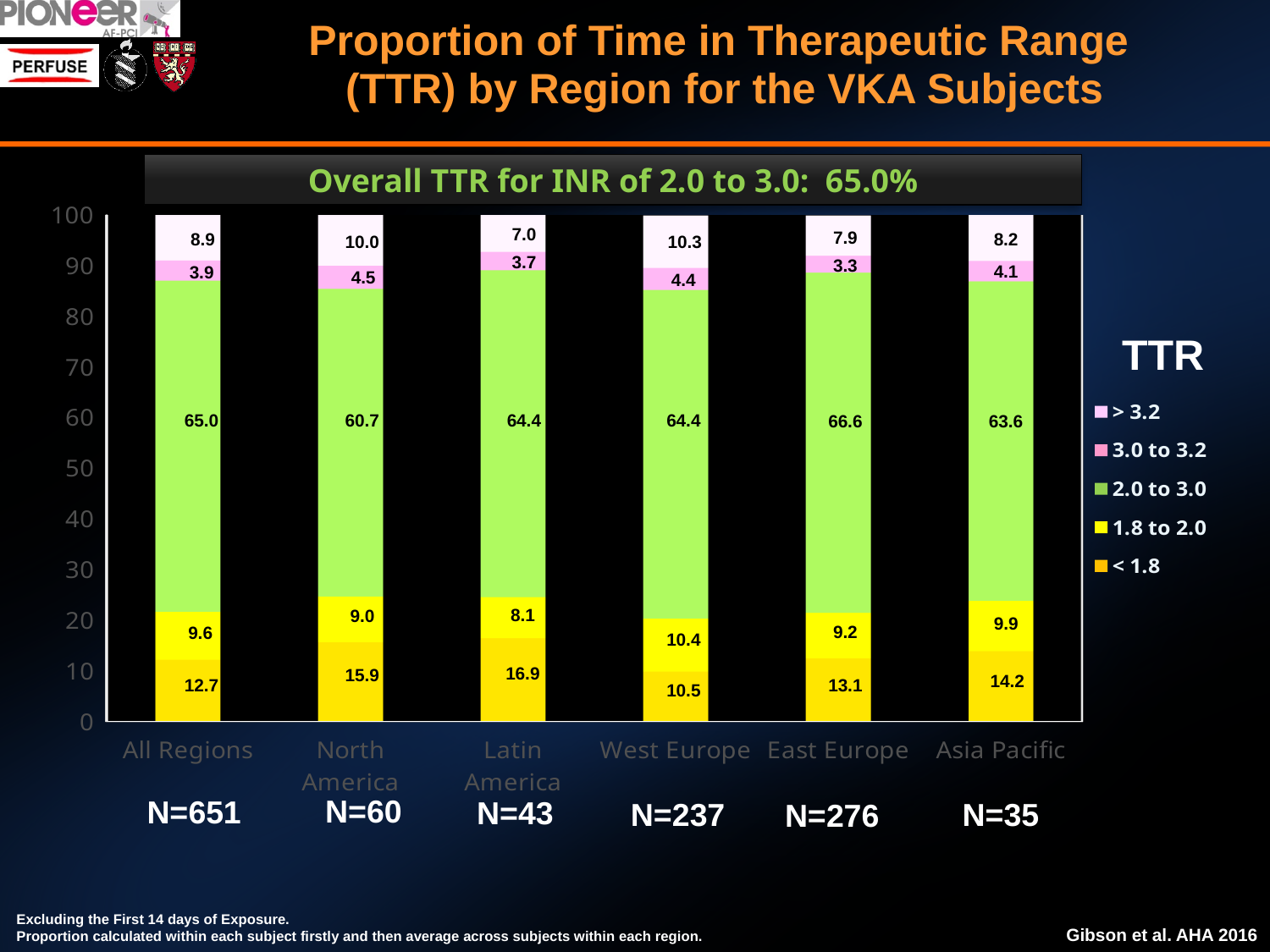
Which region has the lowest value for the 2.0 to 3.0 segment? North America How many series does the legend list? 5 What is the N shown for West Europe? N=237 What kind of chart is shown on the slide? Stacked bar chart Which region has the highest value for the 2.0 to 3.0 segment? East Europe What is the value of the 2.0 to 3.0 segment for East Europe? 66.6 How many regions are shown on the x axis? 6 What is the difference between the 2.0 to 3.0 values for East Europe and North America? 5.9 Which has the larger < 1.8 value, North America or West Europe? North America What is the overall TTR for INR of 2.0 to 3.0 stated above the chart? 65.0% What is the value of the < 1.8 segment for Latin America? 16.9 What is the value of the > 3.2 segment for West Europe? 10.3